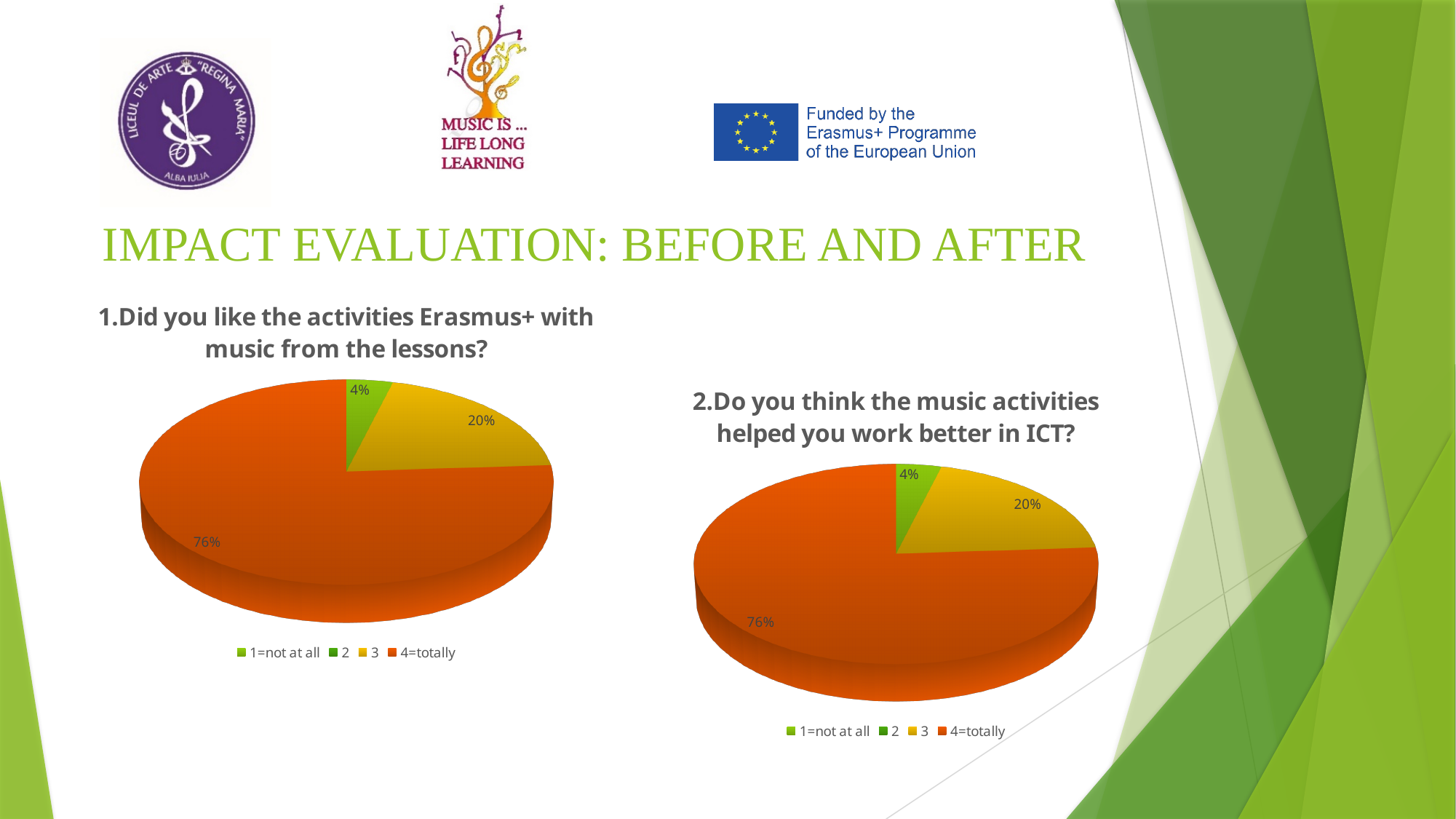
In the chart titled "1.Did you like the activities Erasmus+ with music from the lessons?", what share of the pie is labelled for "4=totally"? 76% What type of chart is the one titled "2.Do you think the music activities helped you work better in ICT?"? Pie chart In the chart titled "2.Do you think the music activities helped you work better in ICT?", what percentage is shown for "1=not at all"? 4% In the chart titled "1.Did you like the activities Erasmus+ with music from the lessons?", what percentage is shown for the "3" slice? 20% In the chart titled "1.Did you like the activities Erasmus+ with music from the lessons?", what is the difference between the "4=totally" and "3" percentages? 56% In the chart titled "2.Do you think the music activities helped you work better in ICT?", which is larger, the "3" slice or the "1=not at all" slice? 3 How many entries does the legend list in the chart titled "1.Did you like the activities Erasmus+ with music from the lessons?"? 4 In the chart titled "2.Do you think the music activities helped you work better in ICT?", what percentage is shown for the "3" slice? 20% In the chart titled "1.Did you like the activities Erasmus+ with music from the lessons?", what percentage is shown for "1=not at all"? 4% In the chart titled "2.Do you think the music activities helped you work better in ICT?", what share of the pie is labelled for "4=totally"? 76% In the chart titled "1.Did you like the activities Erasmus+ with music from the lessons?", which category has the largest slice? 4=totally In the chart titled "2.Do you think the music activities helped you work better in ICT?", which labelled category has the smallest slice? 1=not at all